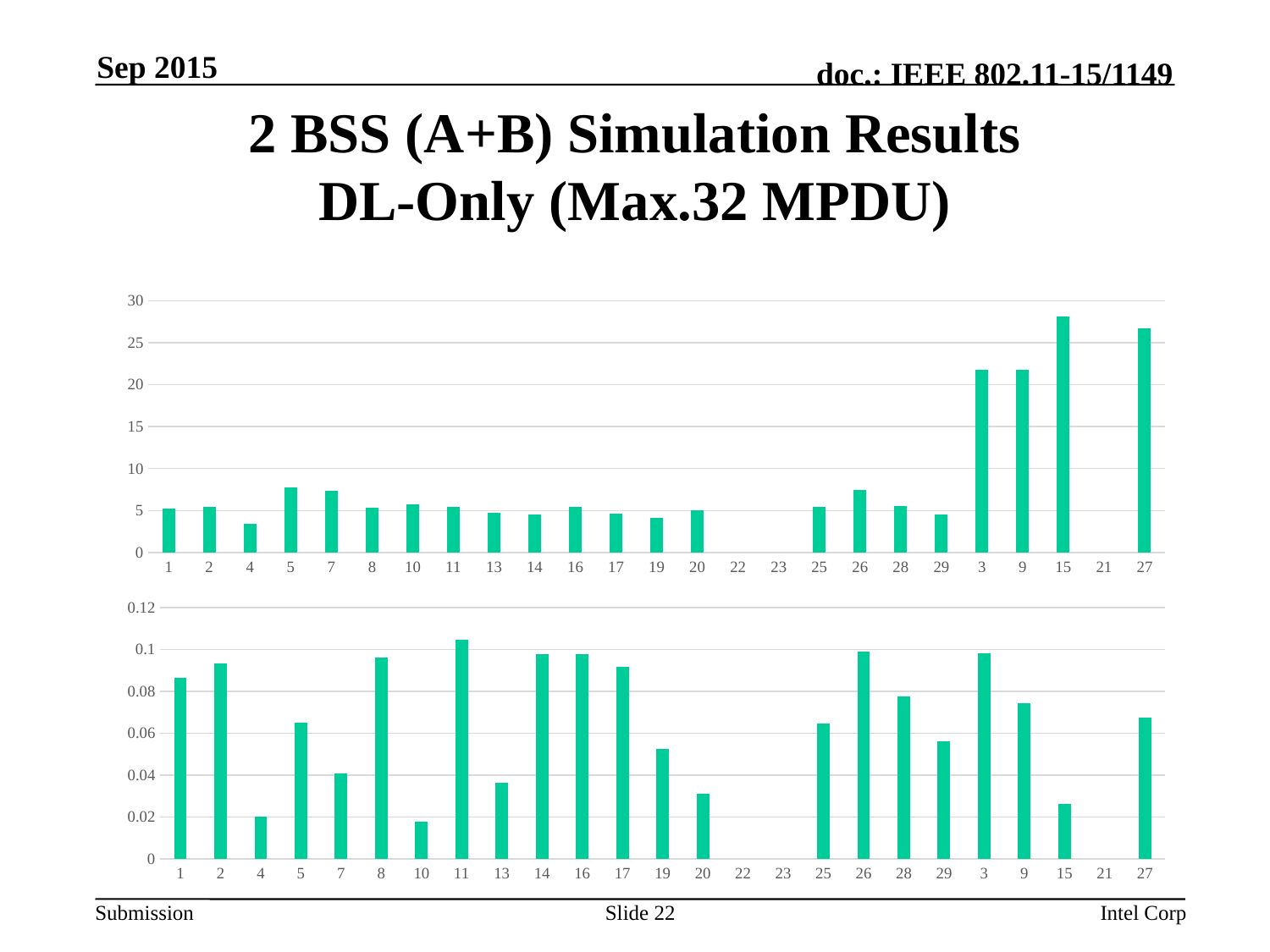
What kind of chart is the bottom chart on the slide? bar chart In the bottom chart, which is larger, the value for category 2 or the value for category 4? 2 In the top chart, is the value for category 15 greater or less than 25? greater How many categories are shown on the x axis of the top chart? 25 What kind of chart is the top chart on the slide? bar chart In the bottom chart, is the value for category 11 greater or less than 0.1? greater In the top chart, which category has the highest value? 15 In the top chart, is the value for category 3 greater or less than 20? greater In the bottom chart, which category has the highest value? 11 In the top chart, which is larger, the value for category 15 or the value for category 27? 15